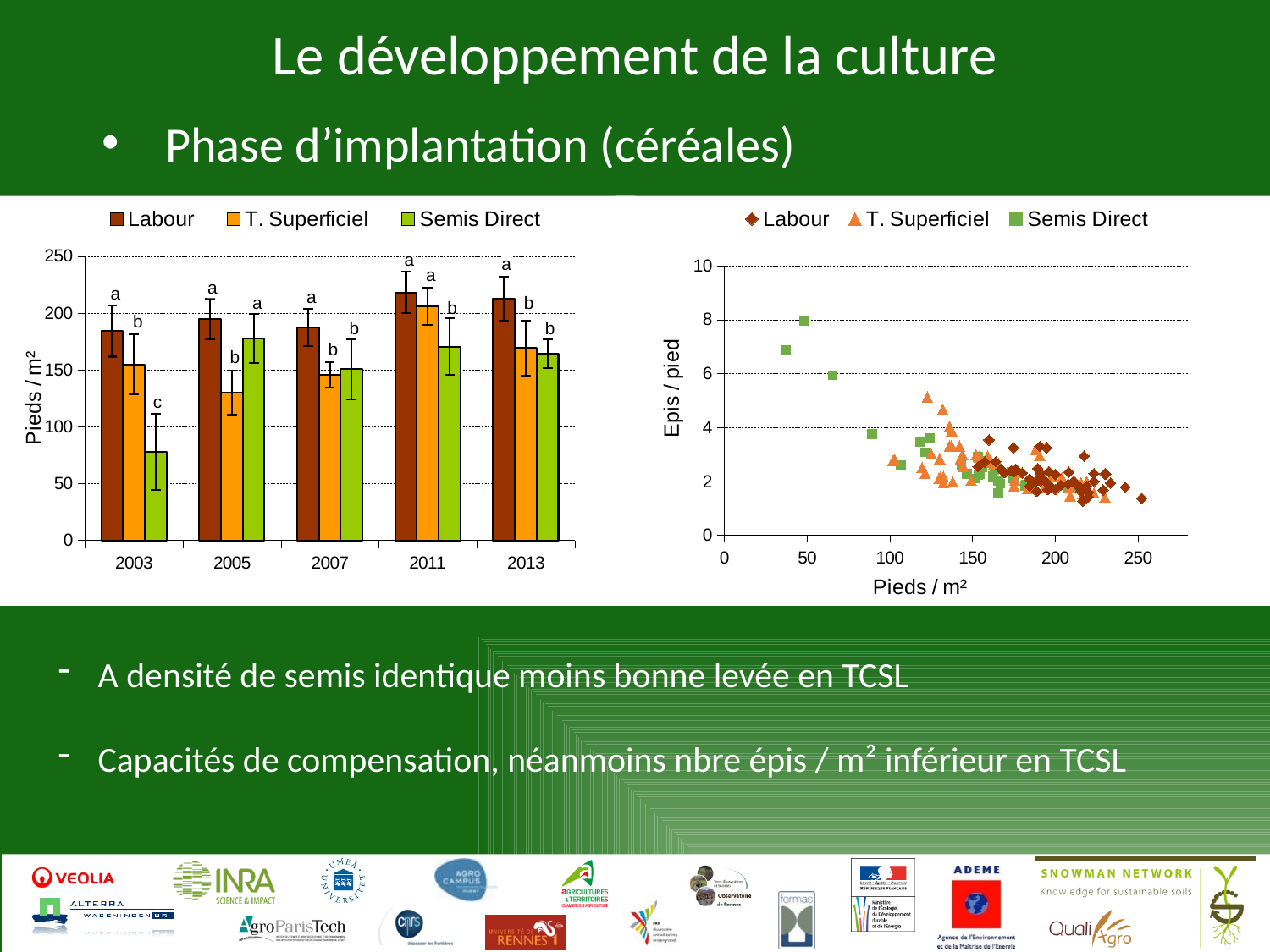
In the left bar chart, how many series does the legend list? 3 In the left bar chart, is the value for T. Superficiel in 2005 greater or less than 150? less In the left bar chart, how many years are shown on the x axis? 5 What kind of chart is the right chart on the slide? scatter chart In the left bar chart, which series has the highest bar in 2003? Labour In the left bar chart, is the value for Labour in 2011 greater or less than 200? greater What kind of chart is the left chart on the slide? bar chart In the left bar chart, which series has the lowest bar in 2005? T. Superficiel In the left bar chart, is the value for Semis Direct in 2003 greater or less than 100? less What is the y-axis label of the right scatter chart? Epis / pied In the left bar chart, which series has the lowest bar in 2003? Semis Direct In the right scatter chart, do the Epis / pied values rise or fall as Pieds / m² increases? fall